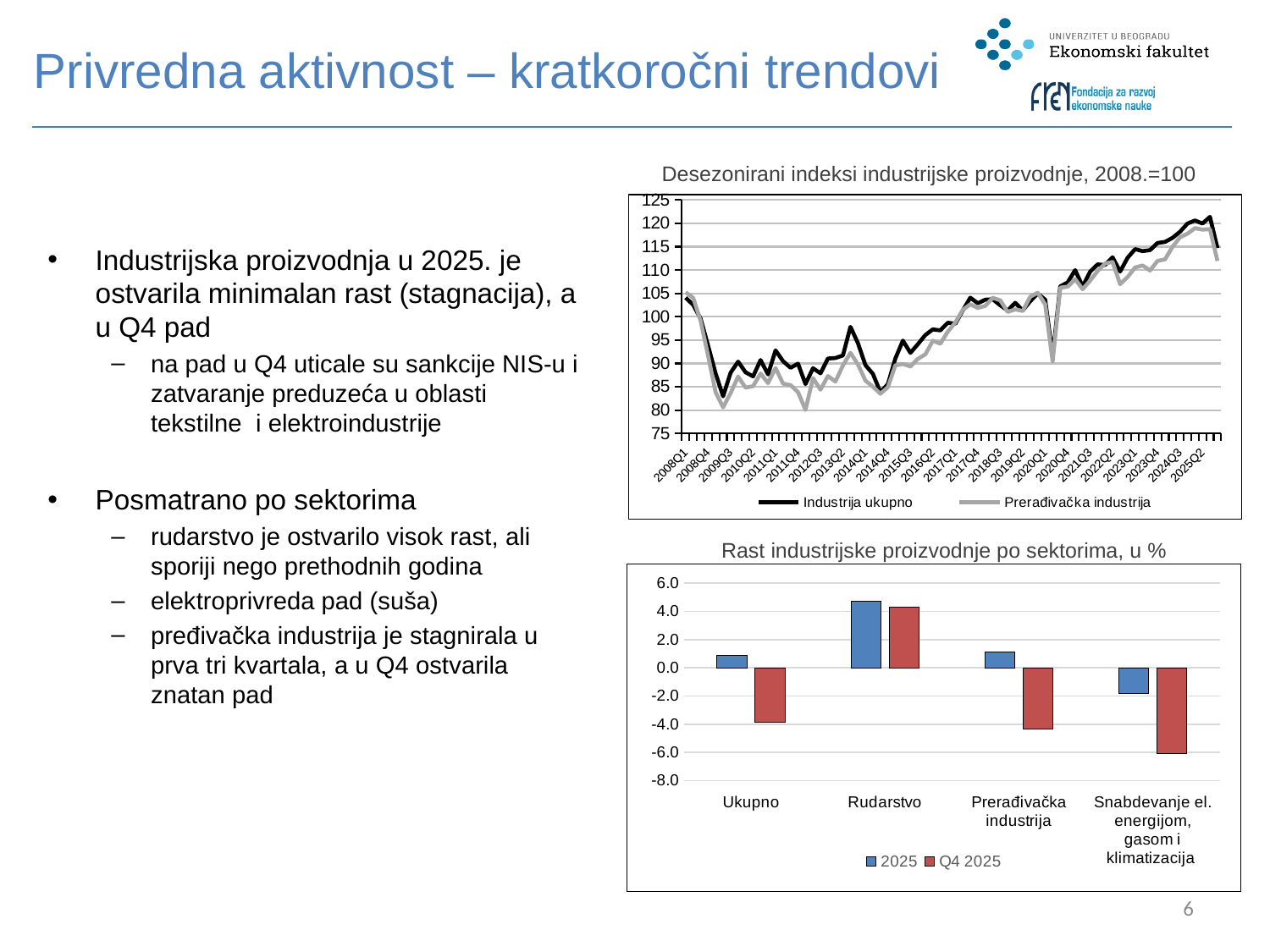
In the bottom chart 'Rast industrijske proizvodnje po sektorima, u %', how many series does the legend list? 2 In the bottom chart 'Rast industrijske proizvodnje po sektorima, u %', how many sector categories are shown on the x axis? 4 In the top chart 'Desezonirani indeksi industrijske proizvodnje, 2008.=100', what are the two series listed in the legend? Industrija ukupno and Prerađivačka industrija In the bottom chart 'Rast industrijske proizvodnje po sektorima, u %', is the 2025 value for Rudarstvo greater or less than 4.0? greater In the bottom chart 'Rast industrijske proizvodnje po sektorima, u %', which category has the highest value for the 2025 series? Rudarstvo In the bottom chart 'Rast industrijske proizvodnje po sektorima, u %', is the Q4 2025 value for Snabdevanje el. energijom, gasom i klimatizacija greater or less than -4.0? less In the bottom chart 'Rast industrijske proizvodnje po sektorima, u %', which category has the highest value for the Q4 2025 series? Rudarstvo What kind of chart is the top chart titled 'Desezonirani indeksi industrijske proizvodnje, 2008.=100'? line chart What kind of chart is the bottom chart titled 'Rast industrijske proizvodnje po sektorima, u %'? bar chart In the bottom chart 'Rast industrijske proizvodnje po sektorima, u %', which is larger for the 2025 series: Ukupno or Snabdevanje el. energijom, gasom i klimatizacija? Ukupno In the bottom chart 'Rast industrijske proizvodnje po sektorima, u %', which category has the lowest value for the Q4 2025 series? Snabdevanje el. energijom, gasom i klimatizacija In the top chart 'Desezonirani indeksi industrijske proizvodnje, 2008.=100', does the Industrija ukupno series rise or fall between 2008Q1 and 2009Q3? fall